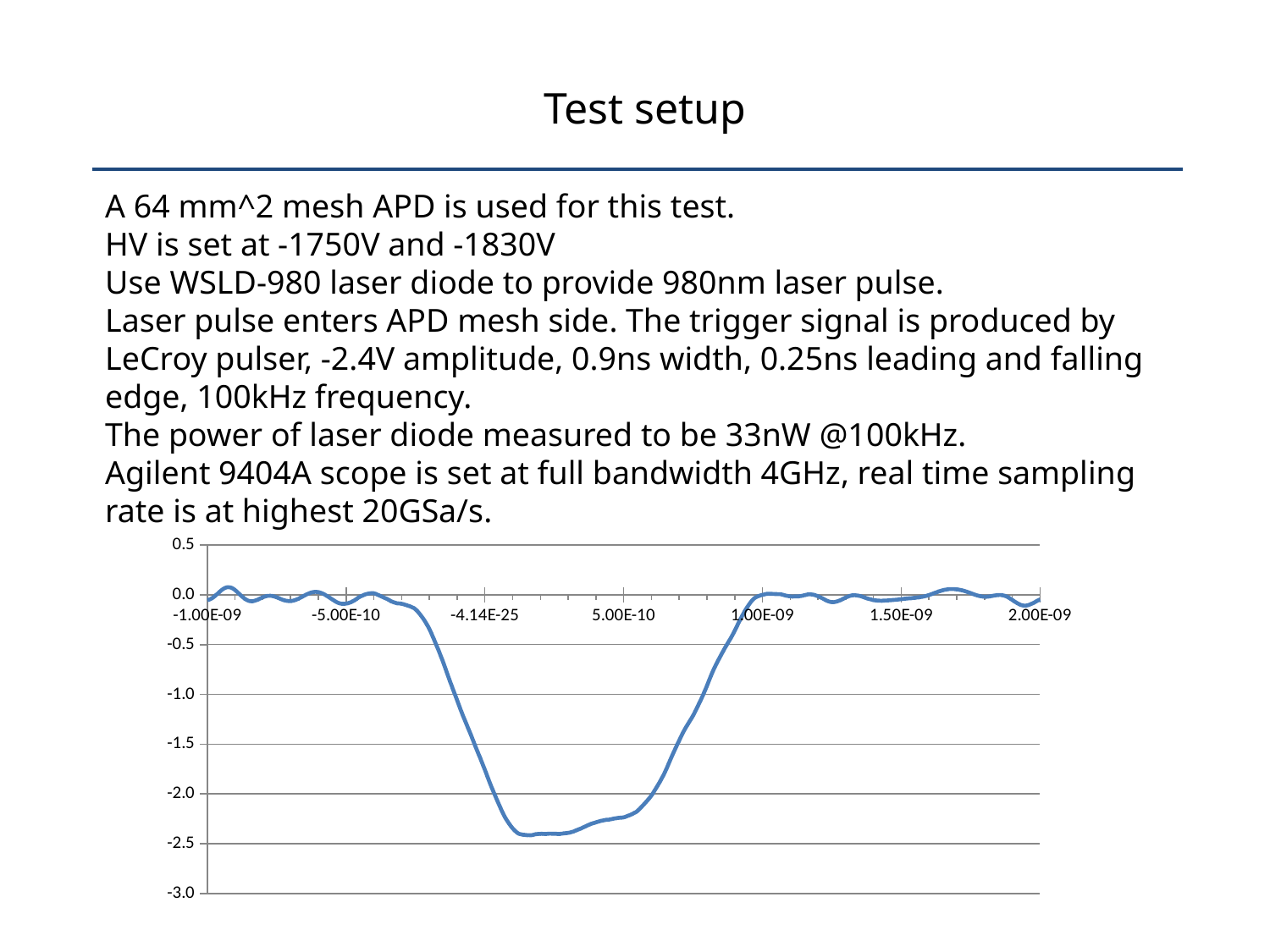
What kind of chart is shown on the slide? line chart Does the line rise or fall between x = 5.00E-10 and x = 1.00E-09? rise Is the value of the line at x = 2.00E-09 greater or less than -0.5? greater Is the value of the line at x = -5.00E-10 greater or less than -0.5? greater Does the line rise or fall between x = -4.14E-25 and x = 5.00E-10? fall Is the lowest point of the line greater or less than -2.0? less What is the highest value shown on the y axis of the chart? 0.5 What is the lowest value shown on the y axis of the chart? -3.0